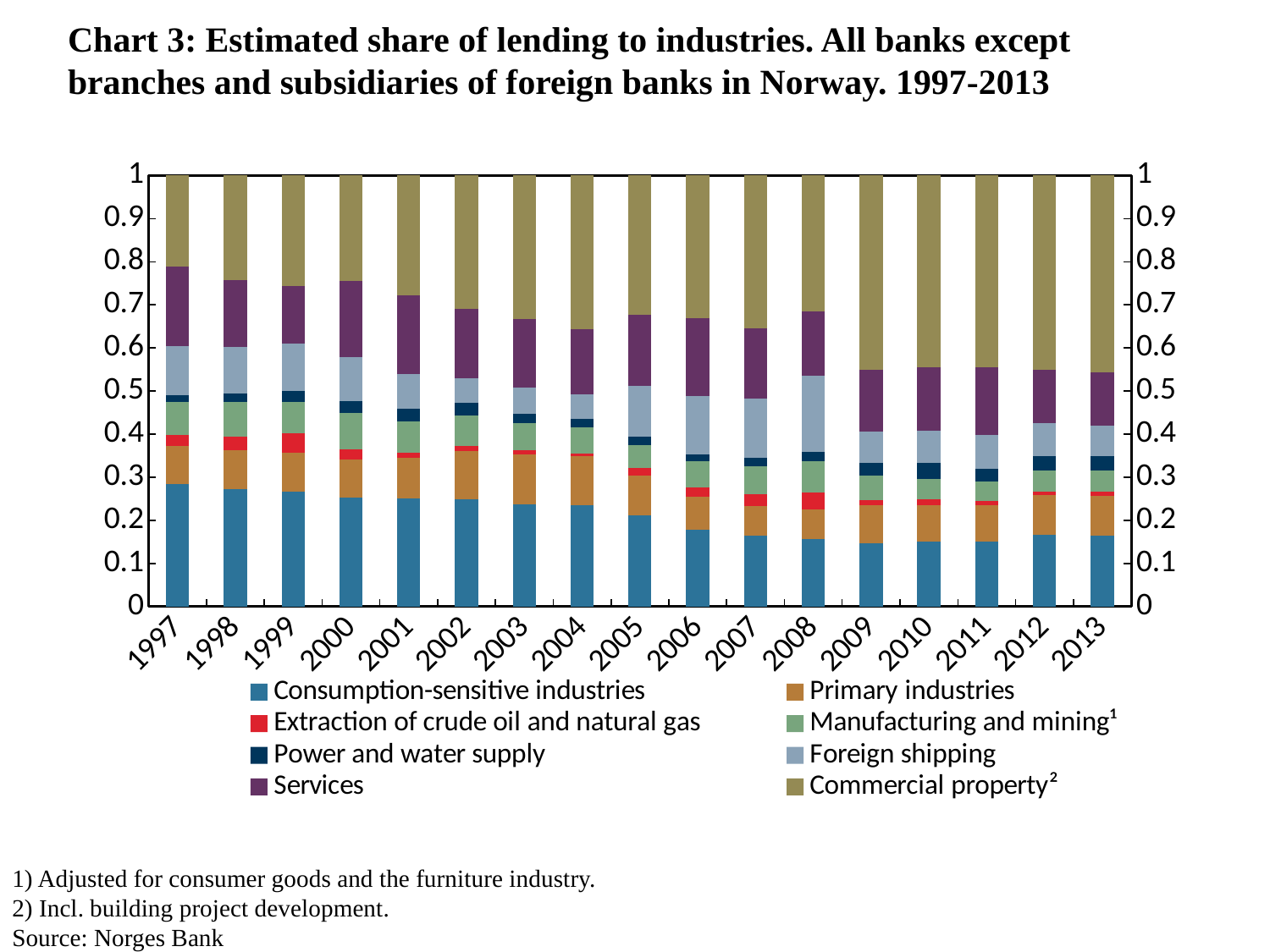
Is the share for Commercial property in 2013 greater or less than 0.4? greater What kind of chart is shown on the slide? Stacked bar chart Which is larger, the Consumption-sensitive industries share in 1997 or in 2013? 1997 Does the share of Consumption-sensitive industries generally rise or fall from 1997 to 2013? fall Does the share of Commercial property generally rise or fall from 1997 to 2013? rise Is the value for Consumption-sensitive industries in 2009 greater or less than 0.2? less How many years are shown along the x axis? 17 How many series does the legend list? 8 Which is larger, the Commercial property share in 1997 or in 2013? 2013 Which series is shown at the top of each stacked bar? Commercial property Is the value for Consumption-sensitive industries in 1997 greater or less than 0.2? greater